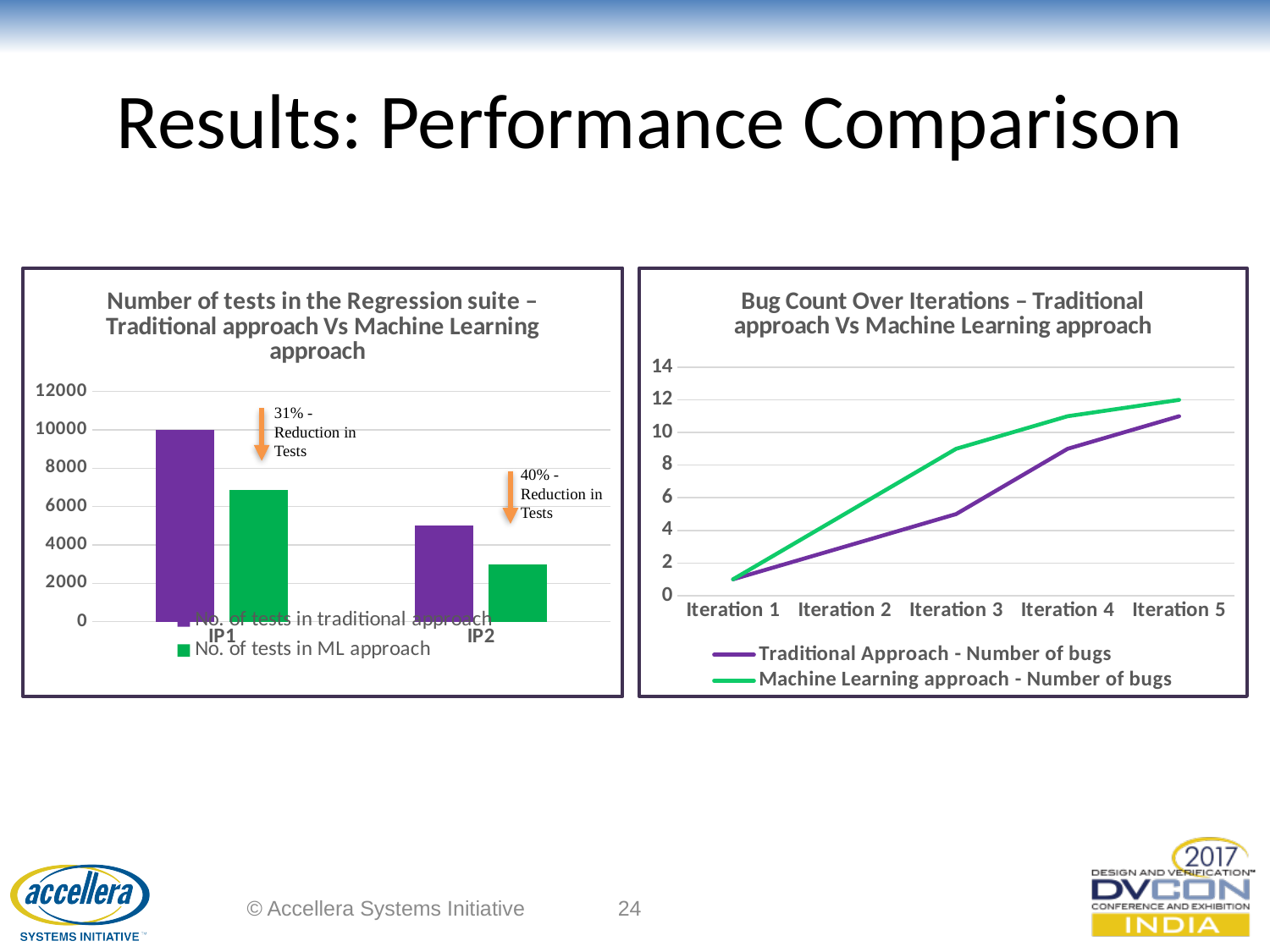
In the right chart, at Iteration 3, which series has more bugs: Traditional Approach or Machine Learning approach? Machine Learning approach In the right chart, what is the Machine Learning approach number of bugs at Iteration 5? 12 In the left chart, is the number of tests in the ML approach for IP2 greater or less than 4000? less In the right chart, how many series does the legend list? 2 In the left chart, which bar is the tallest? No. of tests in traditional approach for IP1 In the left chart, how many IP categories are shown on the x axis? 2 In the left chart, what is the number of tests in the traditional approach for IP1? 10000 What type of chart is the right chart, 'Bug Count Over Iterations'? line chart In the left chart, what percentage reduction in tests is annotated for IP2? 40% In the right chart, is the Traditional Approach number of bugs at Iteration 5 greater or less than 10? greater In the left chart, is the number of tests in the ML approach for IP1 greater or less than 6000? greater What type of chart is the left chart, 'Number of tests in the Regression suite'? bar chart